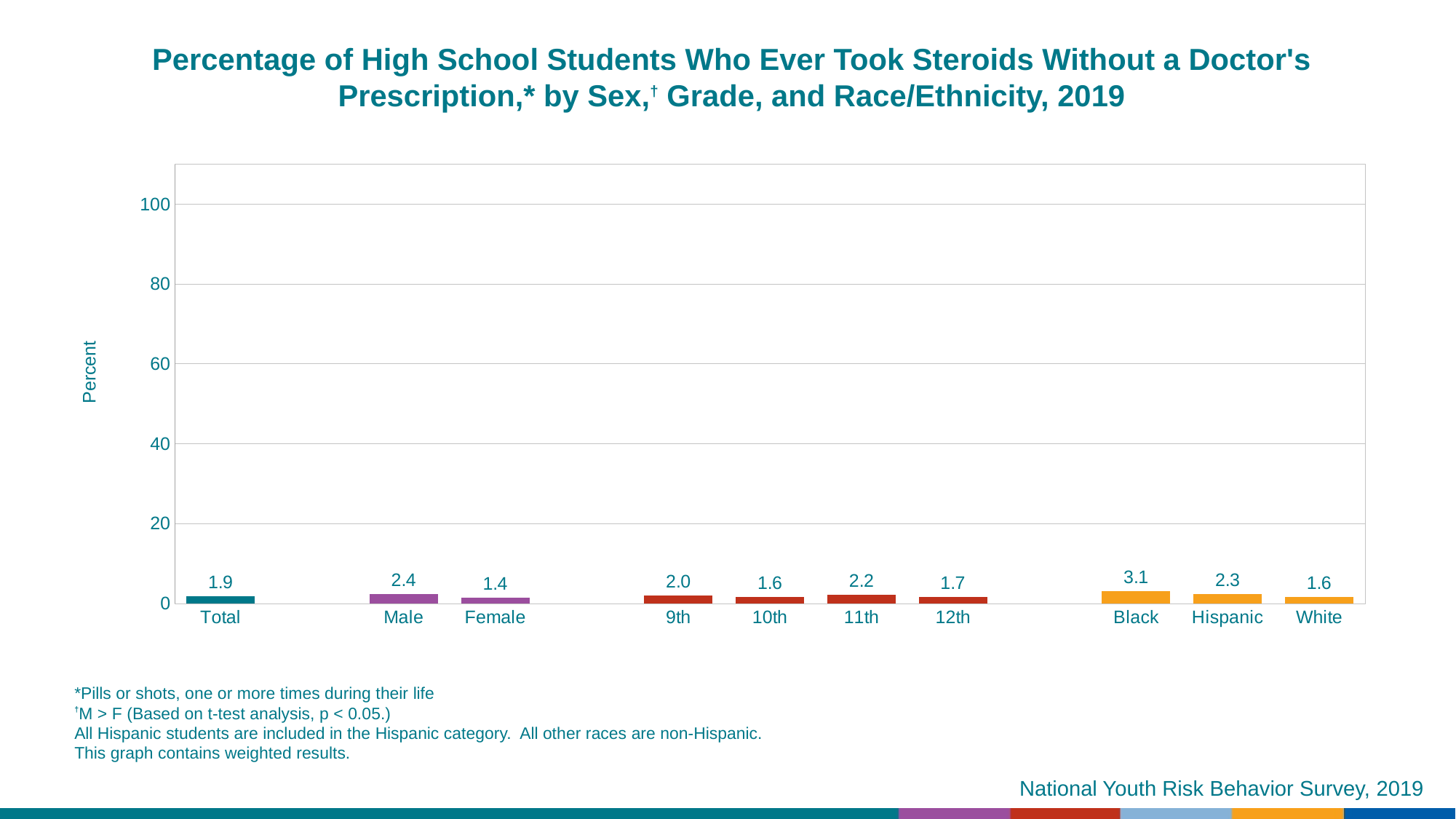
What is the value for Male? 2.4 What is the value for Black? 3.1 Which category has the highest value? Black How many categories are shown on the x axis? 10 Which is larger, the value for Hispanic or the value for White? Hispanic Is the value for Black greater or less than 20? less Which category has the lowest value? Female What is the difference between the values for Male and Female? 1.0 What is the value for 11th grade? 2.2 What kind of chart is shown on the slide? bar chart What is the value for Total? 1.9 What is the label of the y axis? Percent